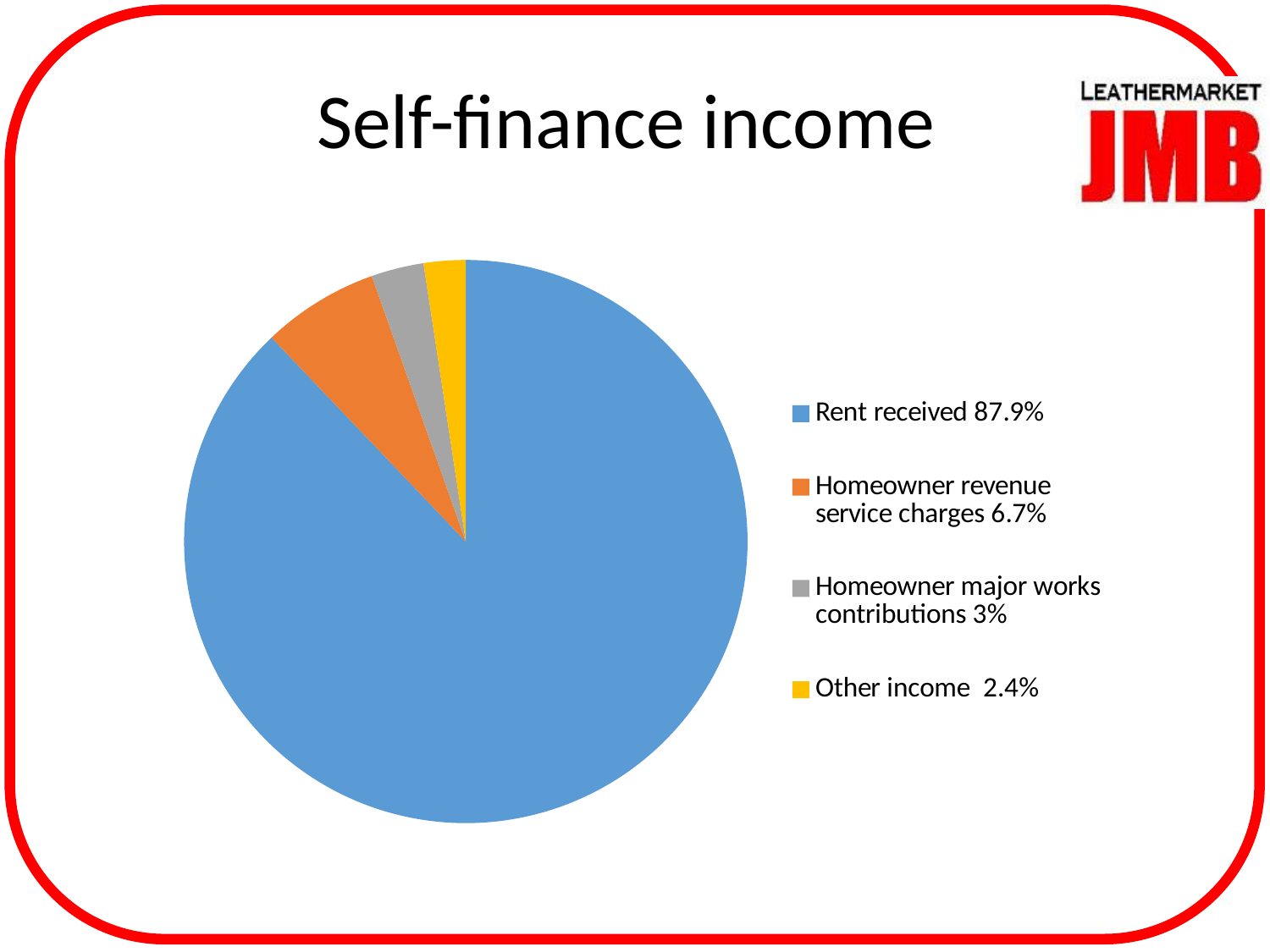
What share of self-finance income is Rent received? 87.9% What share of self-finance income is Other income? 2.4% What is the title of the chart? Self-finance income Which category has the largest share of self-finance income? Rent received What share of self-finance income comes from Homeowner revenue service charges? 6.7% What kind of chart is shown on the slide? pie chart How many categories does the pie chart show? 4 Which category has the smallest share of self-finance income? Other income What colour is the Rent received slice? blue What is the difference between the Rent received share and the Homeowner revenue service charges share? 81.2% Which is larger: Homeowner major works contributions or Other income? Homeowner major works contributions